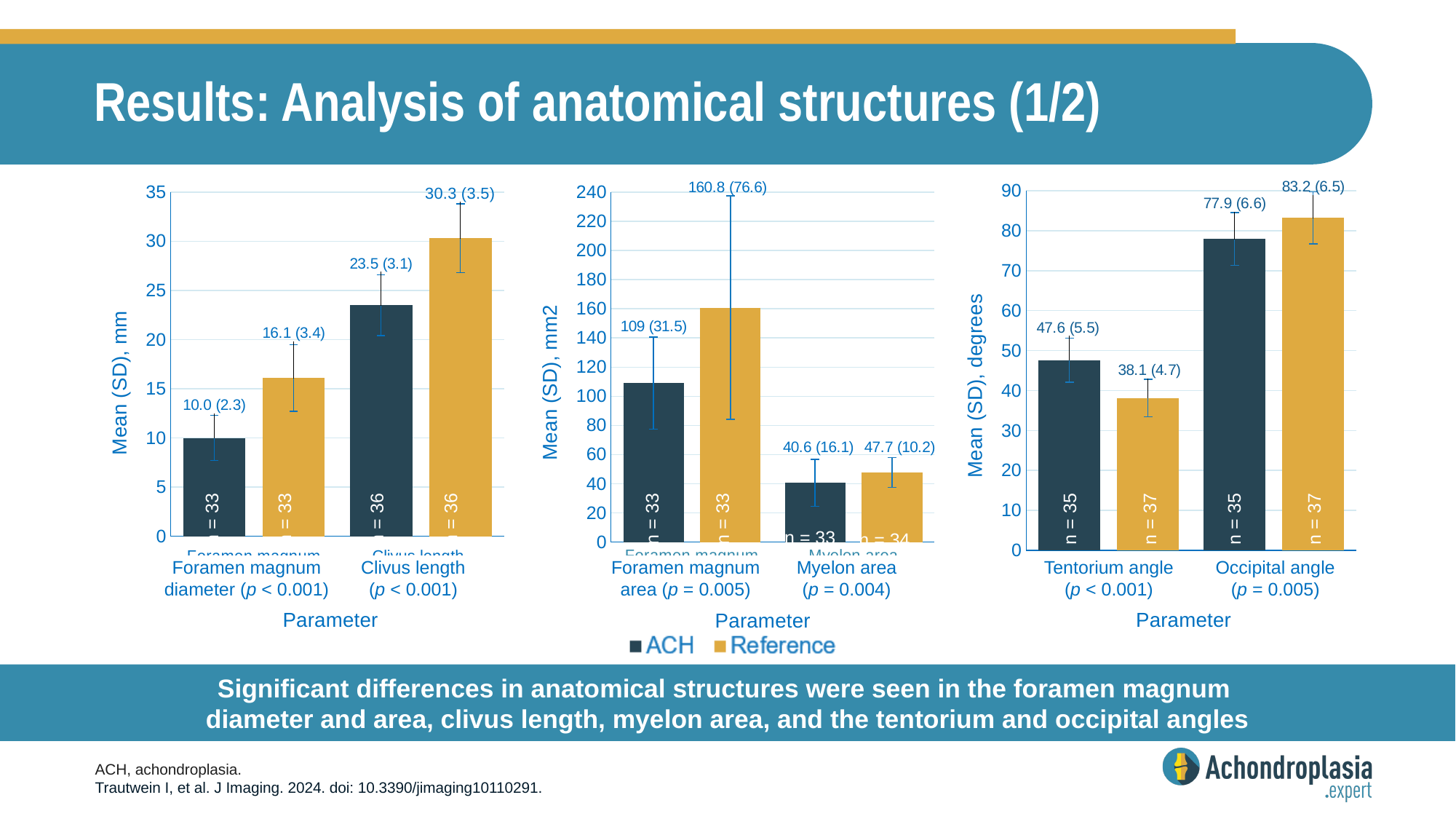
In the right chart (Mean (SD), degrees), which bar is the highest? Reference, Occipital angle In the middle chart (Mean (SD), mm2), what is the data label for the Reference bar for Foramen magnum area? 160.8 (76.6) In the left chart (Mean (SD), mm), what is the difference between the mean Reference and ACH values for Clivus length? 6.8 What kind of chart is the right chart (Mean (SD), degrees)? bar chart In the middle chart (Mean (SD), mm2), which bar is the lowest? ACH, Myelon area How many series does the legend list? 2 In the middle chart (Mean (SD), mm2), what is the difference between the mean Reference and ACH values for Myelon area? 7.1 In the middle chart (Mean (SD), mm2), is the mean ACH value for Foramen magnum area greater or less than 100? greater In the right chart (Mean (SD), degrees), what is the data label for the ACH bar for Tentorium angle? 47.6 (5.5) In the left chart (Mean (SD), mm), what is the data label for the Reference bar for Clivus length? 30.3 (3.5) In the right chart (Mean (SD), degrees), which is larger for Tentorium angle, the ACH mean or the Reference mean? ACH In the left chart (Mean (SD), mm), what is the data label for the ACH bar for Foramen magnum diameter? 10.0 (2.3)